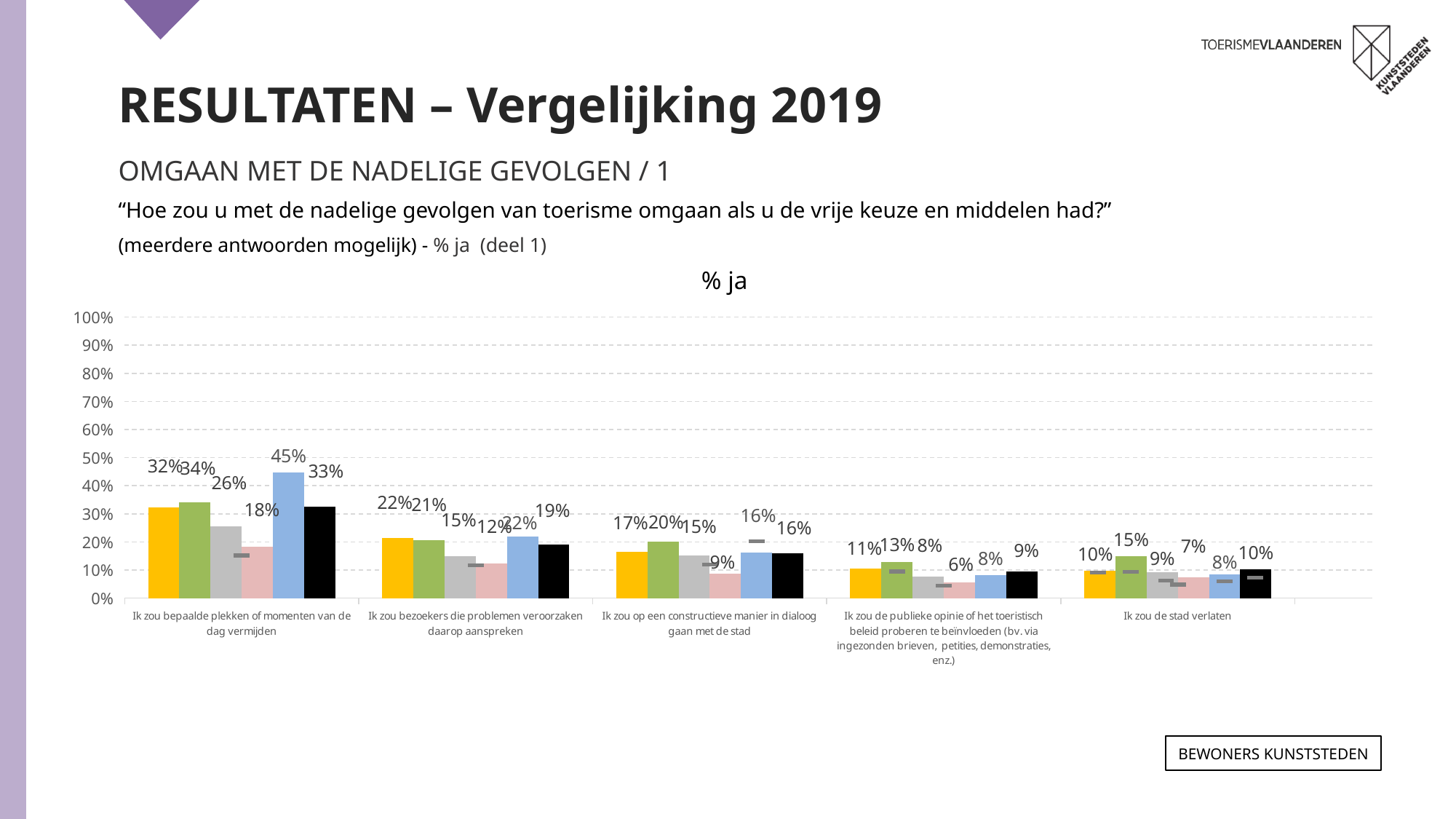
What is the value of the blue bar for 'Ik zou bepaalde plekken of momenten van de dag vermijden'? 45% What is the difference between the blue bar (45%) and the pink bar (18%) for 'Ik zou bepaalde plekken of momenten van de dag vermijden'? 27 percentage points What is the value of the pink bar for 'Ik zou op een constructieve manier in dialoog gaan met de stad'? 9% What is the title of the chart? % ja Which bar is the lowest in the category 'Ik zou de publieke opinie of het toeristisch beleid proberen te beïnvloeden'? the pink bar (6%) What kind of chart is shown on the slide? bar chart Which bar is the highest in the category 'Ik zou bepaalde plekken of momenten van de dag vermijden'? the blue bar (45%) Is the value of the green bar for 'Ik zou bepaalde plekken of momenten van de dag vermijden' greater or less than 30%? greater How many categories are shown along the x axis of the chart? 5 Which is larger for 'Ik zou bezoekers die problemen veroorzaken daarop aanspreken': the yellow bar or the black bar? the yellow bar (22%) What is the value of the green bar for 'Ik zou de stad verlaten'? 15% Across the five categories, do the values of the yellow bars generally rise or fall from left to right? fall